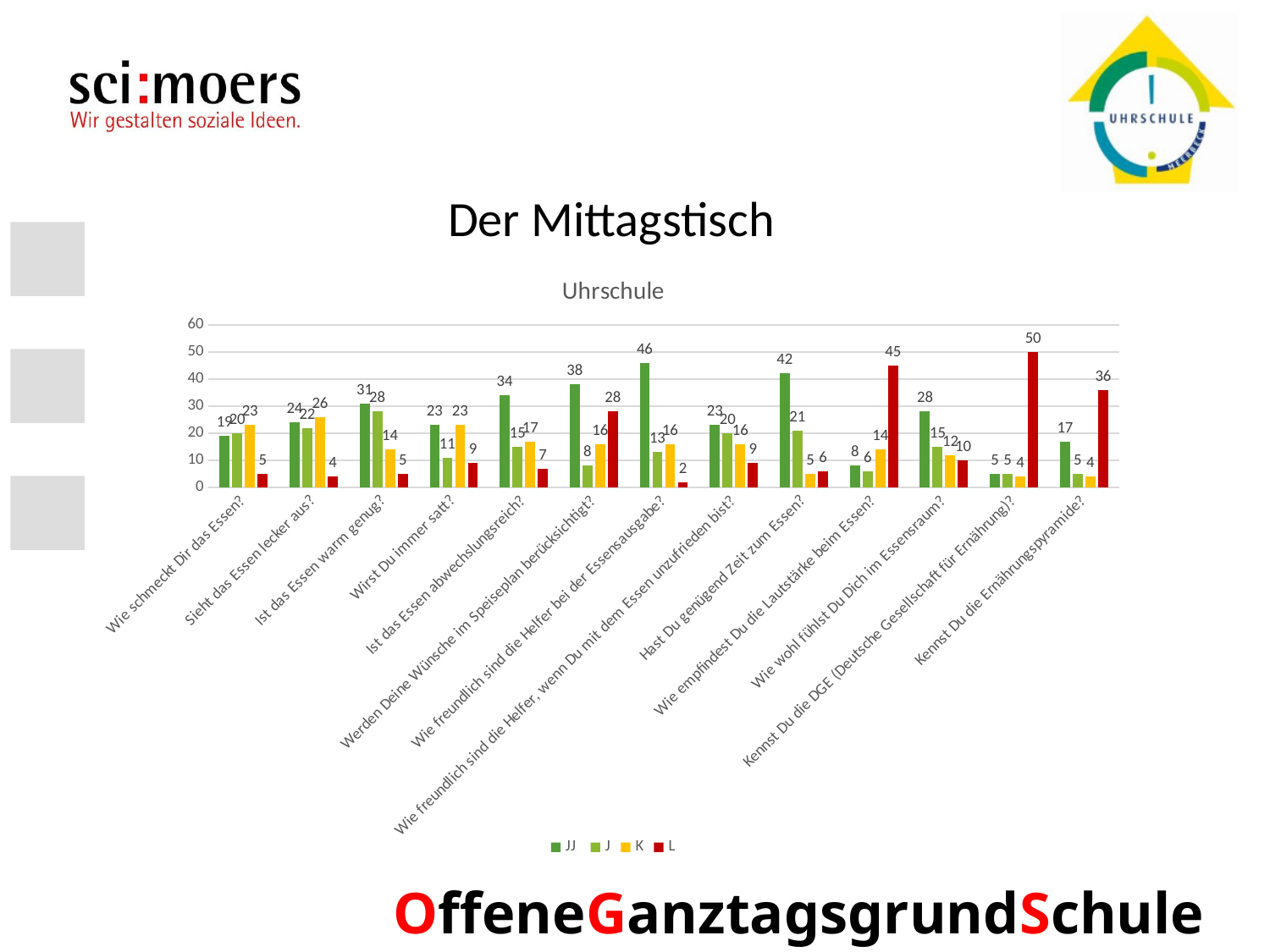
Is the JJ value for "Ist das Essen abwechslungsreich?" greater or less than 30? greater What is the difference between the JJ value and the L value for "Hast Du genügend Zeit zum Essen?"? 36 What is the title of the chart? Uhrschule Which category has the highest JJ value? Wie freundlich sind die Helfer bei der Essensausgabe? What is the value of the JJ series for "Wie freundlich sind die Helfer bei der Essensausgabe?"? 46 What kind of chart is shown on the slide? Bar chart What is the value of the L series for "Kennst Du die DGE (Deutsche Gesellschaft für Ernährung)?"? 50 For "Wie empfindest Du die Lautstärke beim Essen?", which is larger, the JJ value or the L value? L What is the value of the K series for "Sieht das Essen lecker aus?"? 26 How many series does the legend list? 4 Which category has the lowest L value? Wie freundlich sind die Helfer bei der Essensausgabe? How many categories (questions) are shown on the x axis? 13